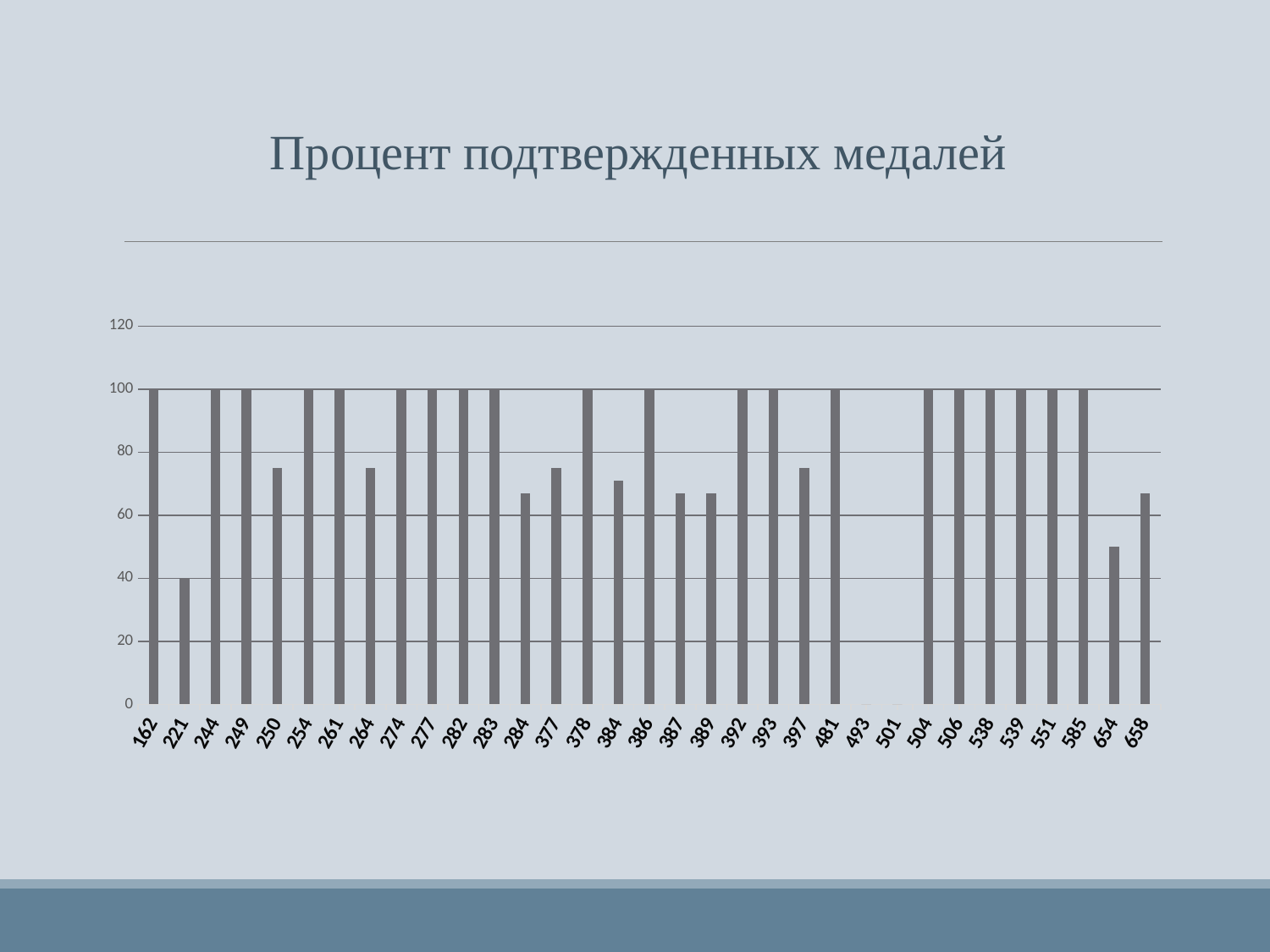
What is the value for category 221? 40 What is the difference between the value for 162 and the value for 221? 60 Is the value for category 284 greater or less than 80? less Is the value for category 250 greater or less than 60? greater What kind of chart is shown on the slide? bar chart What is the value for category 162? 100 What is the value for category 493? 0 How many categories have no visible bar (a value of 0)? 2 Is the value for category 654 greater or less than 60? less How many categories are shown on the x axis? 33 What is the title of the chart? Процент подтвержденных медалей Which is larger, the value for 221 or the value for 244? 244